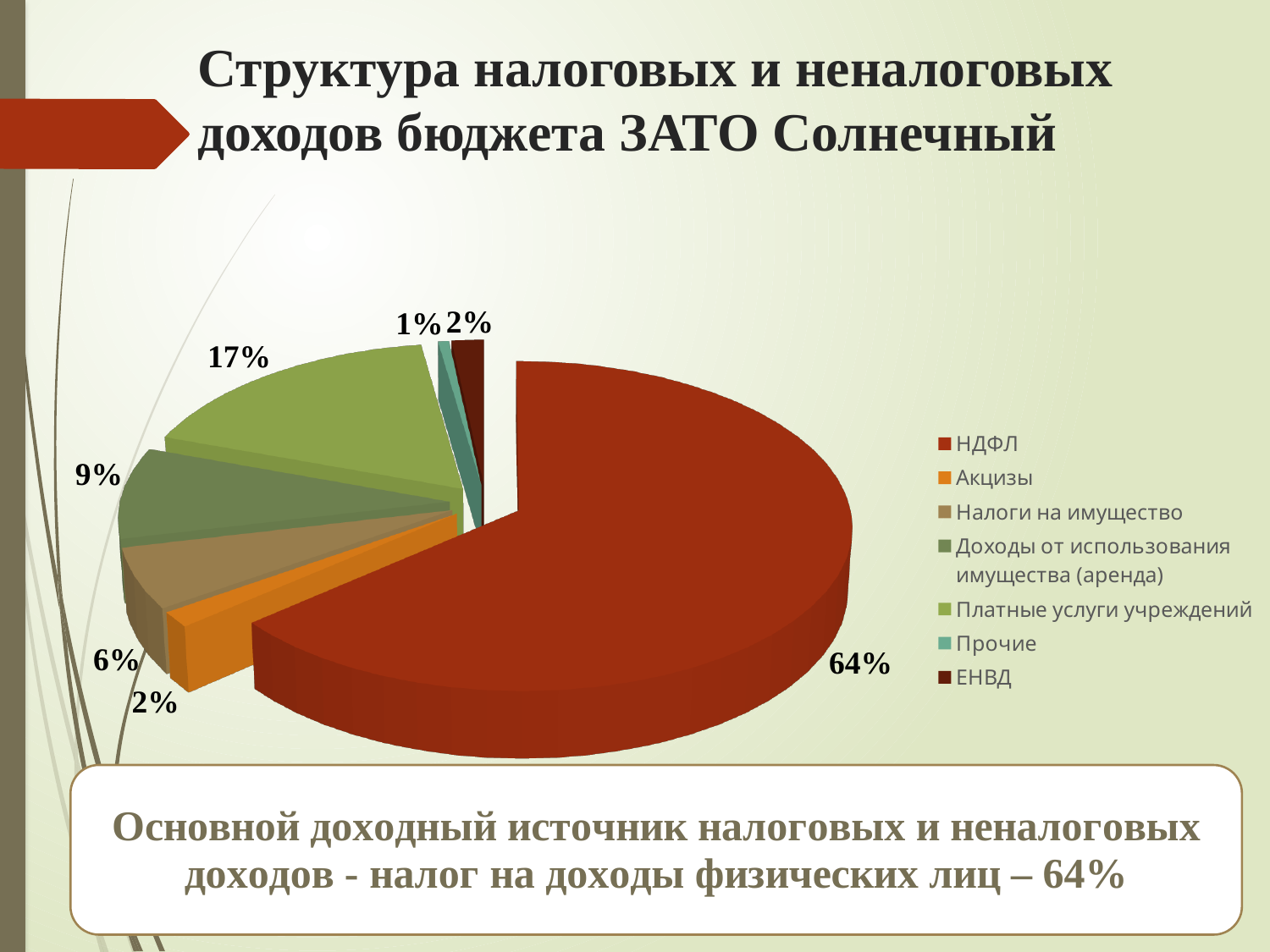
What is the difference between the shares of НДФЛ and Платные услуги учреждений? 47% Which category has the smallest share of the pie? Прочие What is the value for Доходы от использования имущества (аренда)? 9% What is the value for Прочие? 1% What is the value for Платные услуги учреждений? 17% How many categories does the legend list? 7 Which is larger, the share of Налоги на имущество or the share of Доходы от использования имущества (аренда)? Доходы от использования имущества (аренда) What colour is the slice for НДФЛ? red Which category has the largest share of the pie? НДФЛ What is the value for Налоги на имущество? 6% What share of the pie does НДФЛ have? 64% What kind of chart is shown on the slide? pie chart